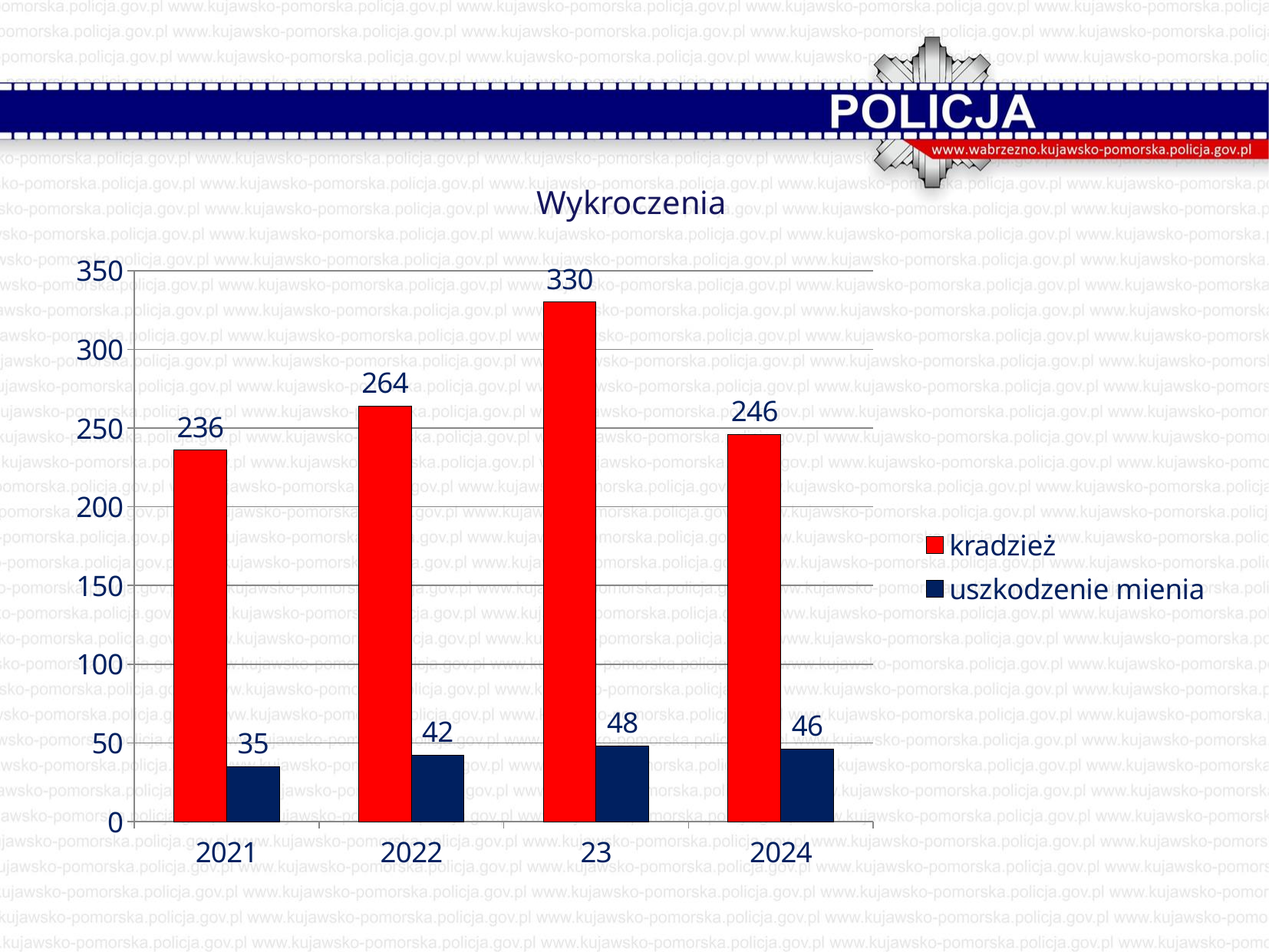
What is the value for uszkodzenie mienia in 2024? 46 Which is larger: kradzież in 2024 or kradzież in 2022? kradzież in 2022 How many categories are shown on the x axis? 4 What is the difference between the kradzież values for 2022 and 2021? 28 What is the title of the chart? Wykroczenia What kind of chart is shown on the slide? bar chart Which category has the lowest value for uszkodzenie mienia? 2021 Which category has the highest value for kradzież? 23 What is the value for kradzież in 2022? 264 What is the difference between the uszkodzenie mienia values for the category labelled 23 and 2024? 2 What is the value for kradzież in 2021? 236 How many series does the legend list? 2